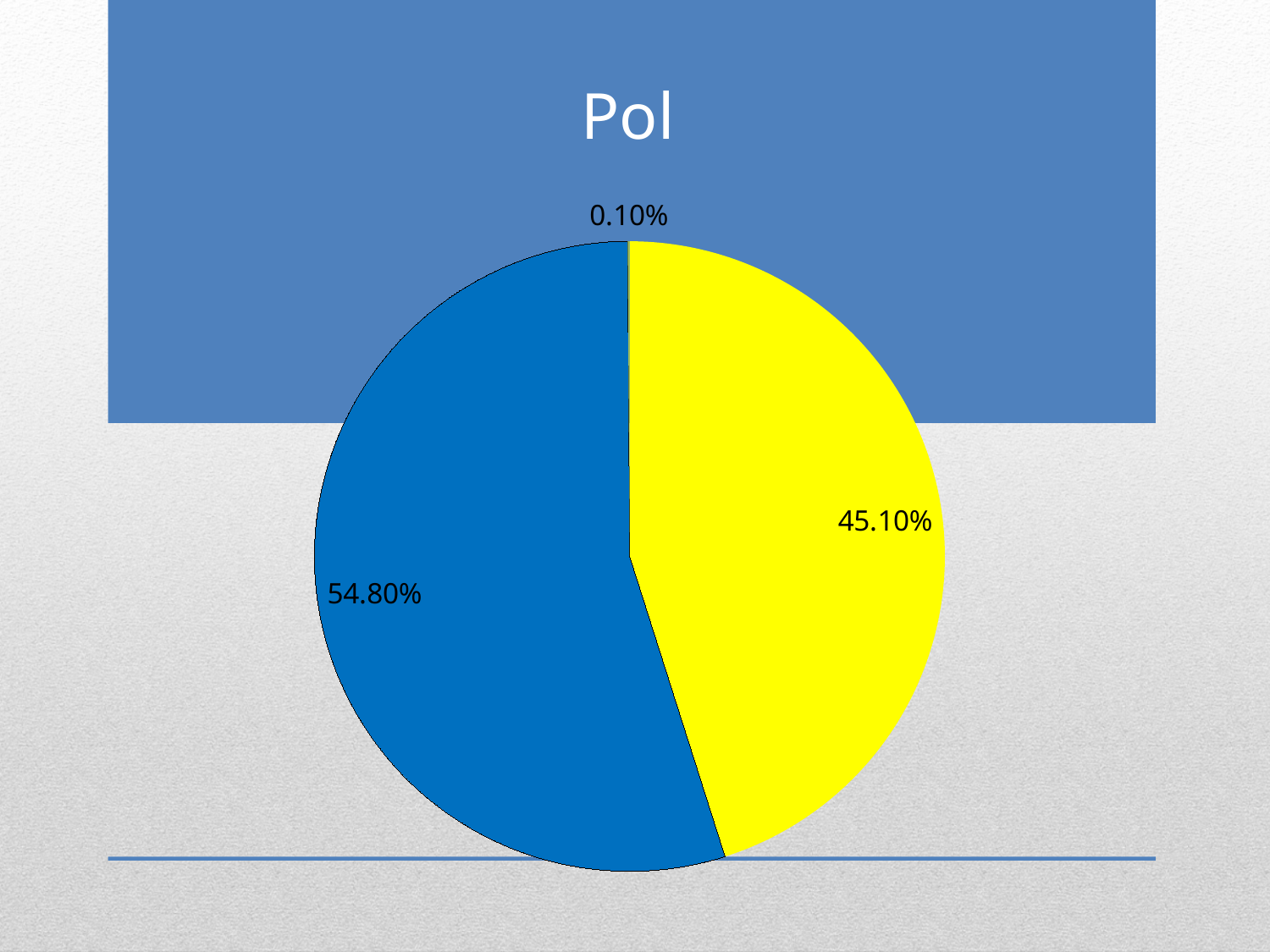
What is the difference between the blue slice (54.80%) and the yellow slice (45.10%)? 9.70% What is the value of the largest slice of the pie chart? 54.80% What colour is the largest slice of the pie chart? blue Which slice is larger, the blue slice or the yellow slice? the blue slice What is the title of the chart? Pol What is the value of the smallest slice of the pie chart? 0.10% What is the difference between the yellow slice (45.10%) and the smallest slice (0.10%)? 45.00% Is the blue slice greater or less than 50% of the pie? greater What kind of chart is shown on the slide? pie chart What share of the pie does the blue slice represent? 54.80% How many slices does the pie chart have? 3 What share of the pie does the yellow slice represent? 45.10%